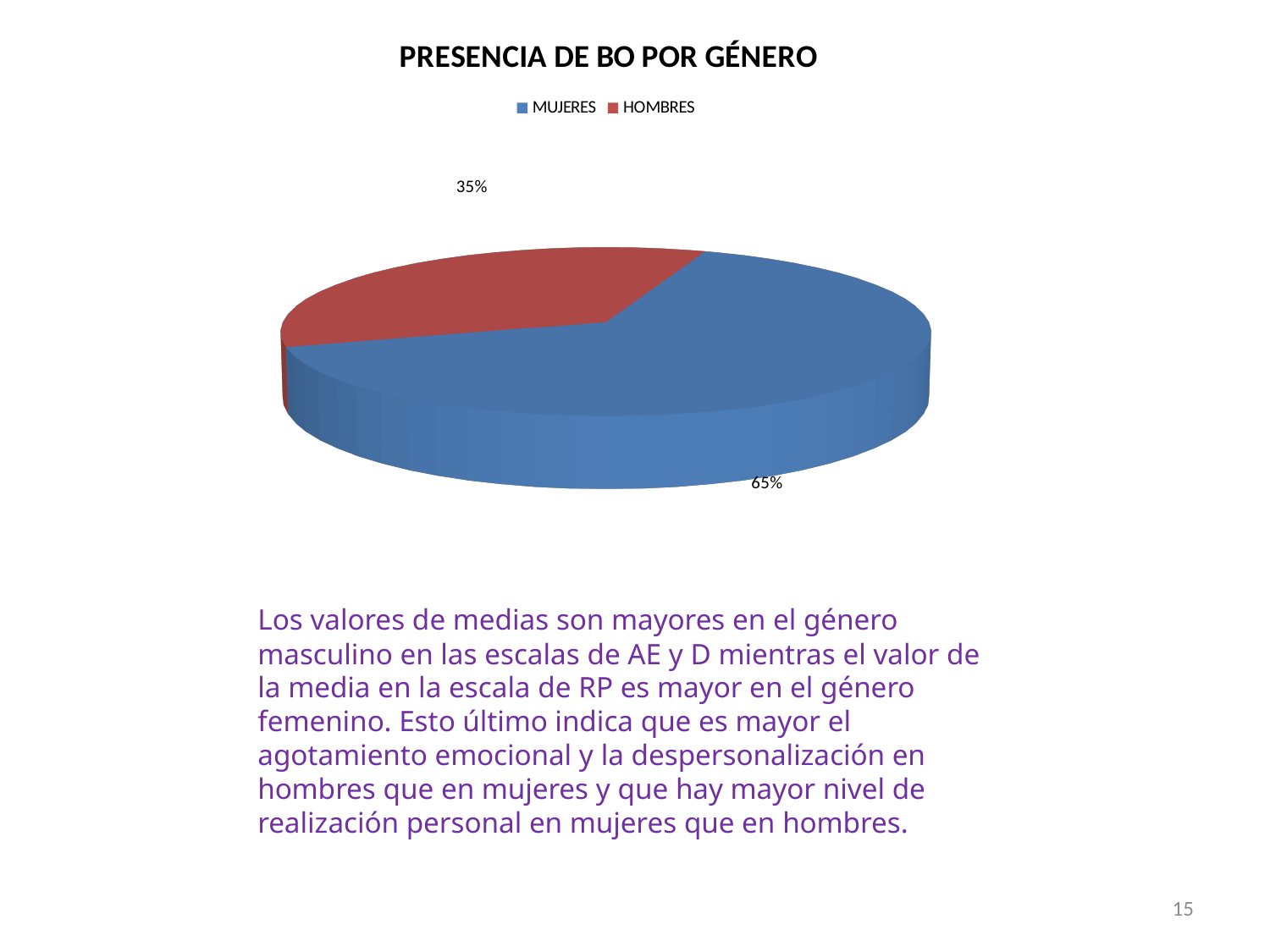
What percentage of the pie corresponds to MUJERES? 65% What colour is the HOMBRES slice? red How many categories does the legend list? 2 How many slices does the pie chart have? 2 What is the share of the pie taken by the MUJERES slice? 65% What is the title of the chart? PRESENCIA DE BO POR GÉNERO What percentage of the pie corresponds to HOMBRES? 35% What is the difference in percentage points between the MUJERES and HOMBRES slices? 30 What kind of chart is shown on the slide? pie chart Which category has the smallest share of the pie? HOMBRES Which slice is larger, MUJERES or HOMBRES? MUJERES Which category has the largest share of the pie? MUJERES